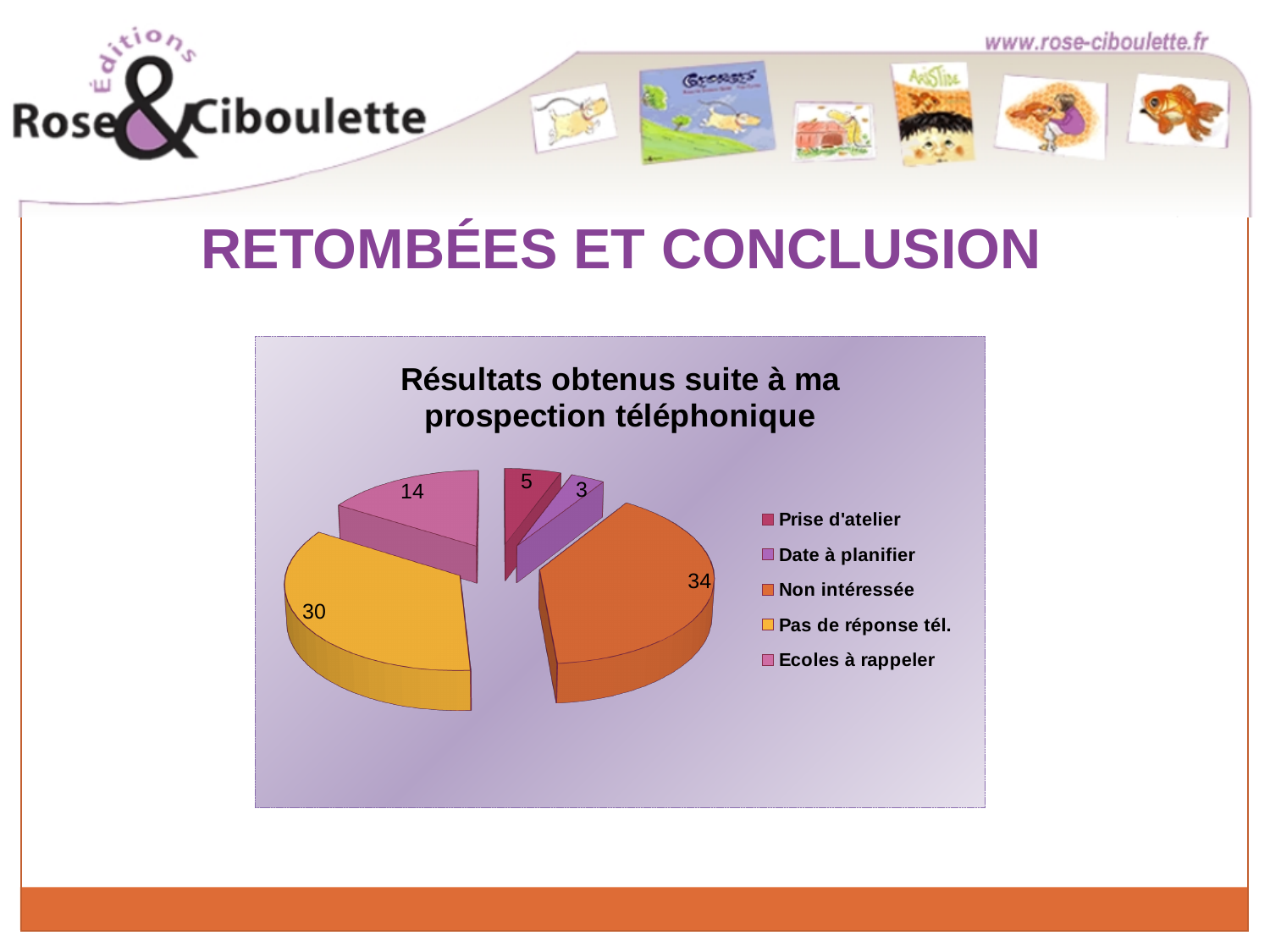
What is the value for "Date à planifier"? 3 Which is larger, "Ecoles à rappeler" or "Prise d'atelier"? Ecoles à rappeler What is the title of the chart? Résultats obtenus suite à ma prospection téléphonique Which category has the largest slice of the pie? Non intéressée What type of chart is shown on the slide? Pie chart What is the value for "Pas de réponse tél."? 30 What is the value for "Prise d'atelier"? 5 What is the difference between the values for "Non intéressée" and "Pas de réponse tél."? 4 How many categories does the legend list? 5 Which category has the smallest slice of the pie? Date à planifier What is the value for "Ecoles à rappeler"? 14 What is the value for "Non intéressée"? 34